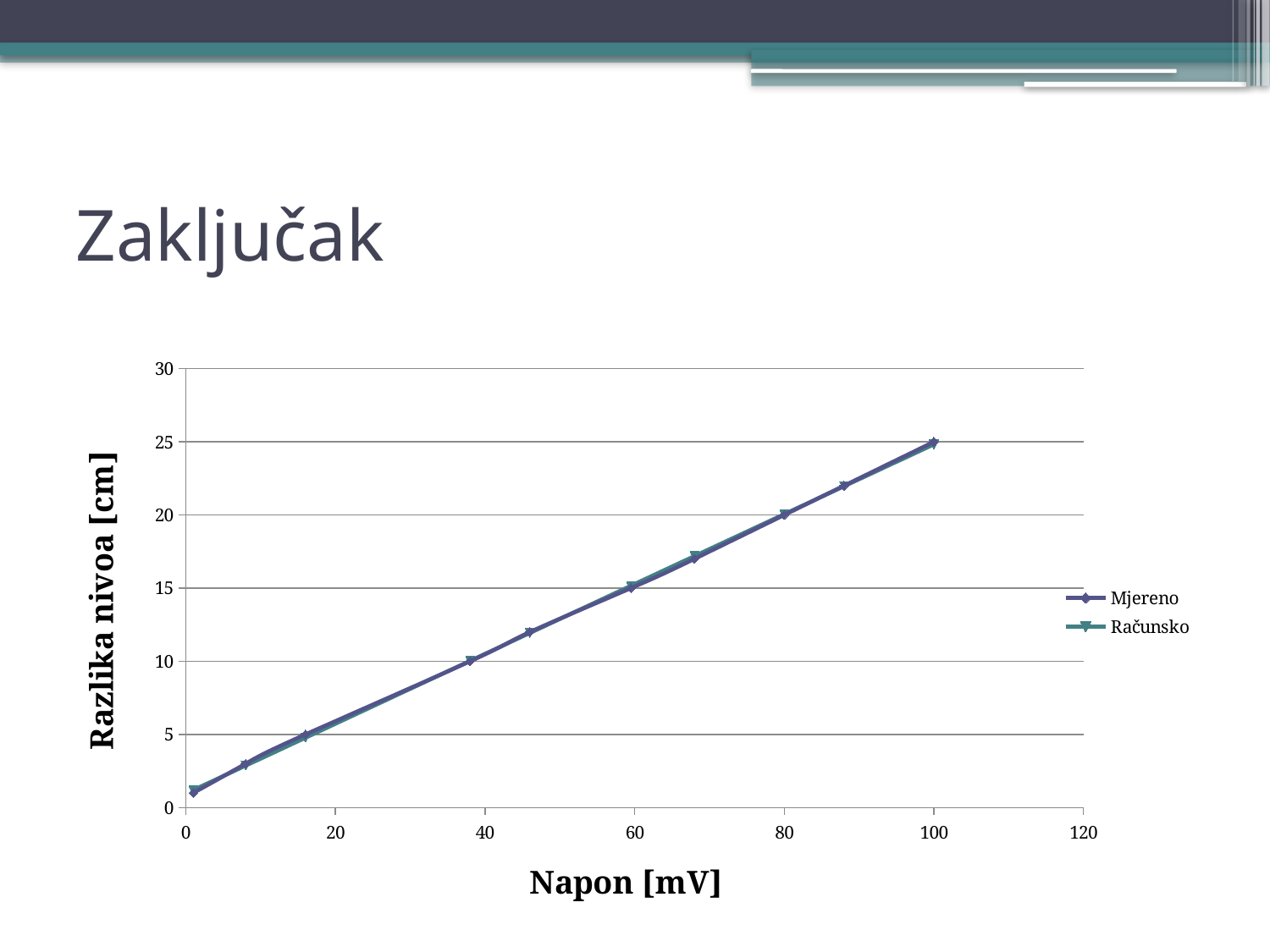
What is the title of the x axis? Napon [mV] What is the maximum value shown on the y axis? 30 What are the names of the two series in the legend? Mjereno and Računsko Do the values of the Mjereno series rise or fall as Napon increases? rise Is the Mjereno value at Napon 68 mV greater or less than 15? greater How many series does the legend list? 2 At which Napon value does the Mjereno series reach its highest Razlika nivoa? 100 Is the Mjereno value at Napon 46 mV greater or less than 10? greater Is the Mjereno value at Napon 88 mV greater or less than 20? greater What kind of chart is shown on the slide? line chart Do the values of the Računsko series rise or fall as Napon increases? rise